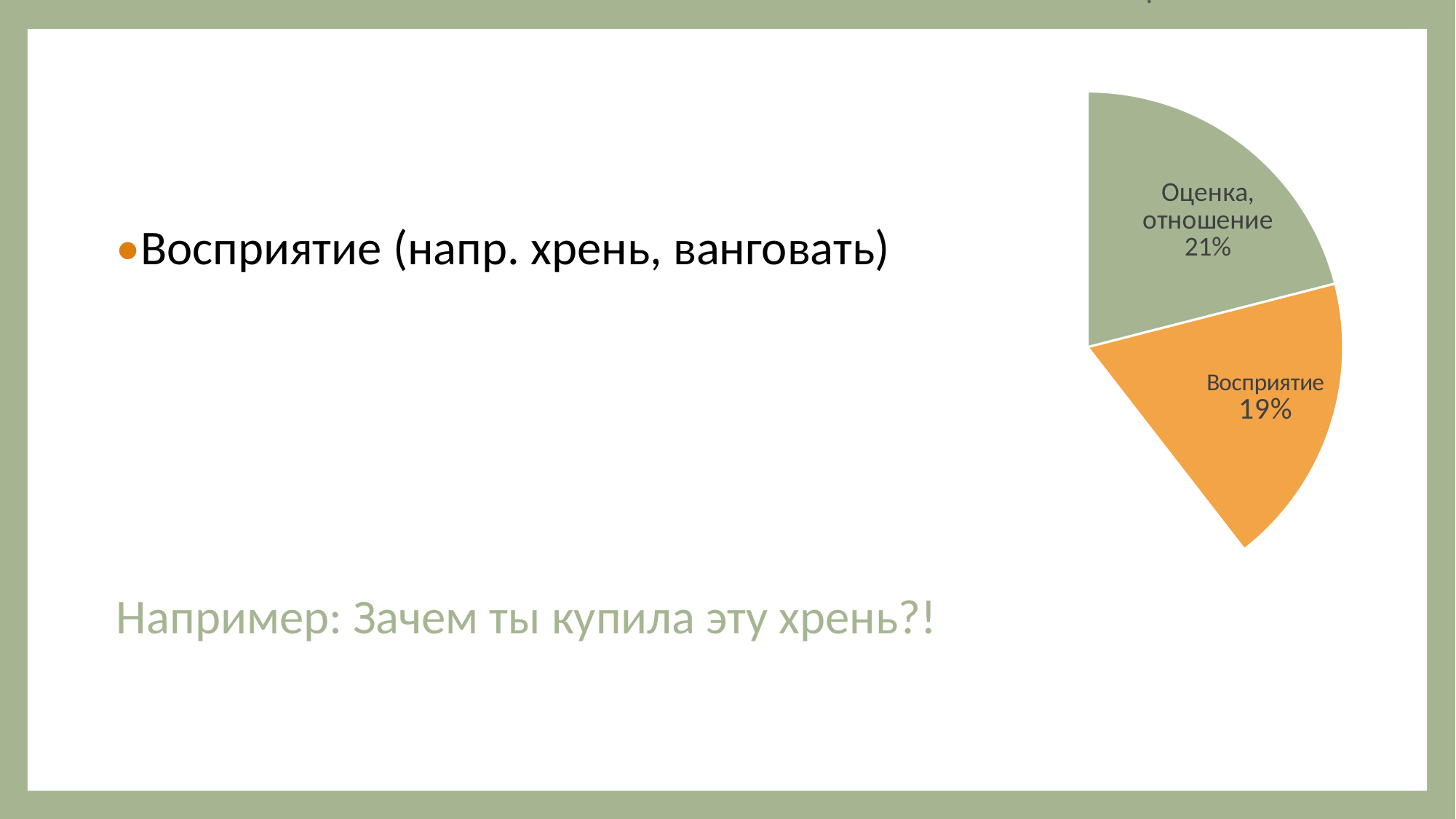
Is the value for "Оценка, отношение" greater or less than 20%? greater How many labelled slices are visible in the pie chart? 2 What colour is the "Восприятие" slice of the pie chart? Orange What percentage is shown for the "Восприятие" slice of the pie chart? 19% Is the value for "Восприятие" greater or less than 20%? less Which of the two labelled slices is larger: "Оценка, отношение" or "Восприятие"? Оценка, отношение By how many percentage points does the "Оценка, отношение" slice exceed the "Восприятие" slice? 2 percentage points What colour is the "Оценка, отношение" slice of the pie chart? Green What kind of chart is shown on the right side of the slide? Pie chart What percentage is shown for the "Оценка, отношение" slice of the pie chart? 21%